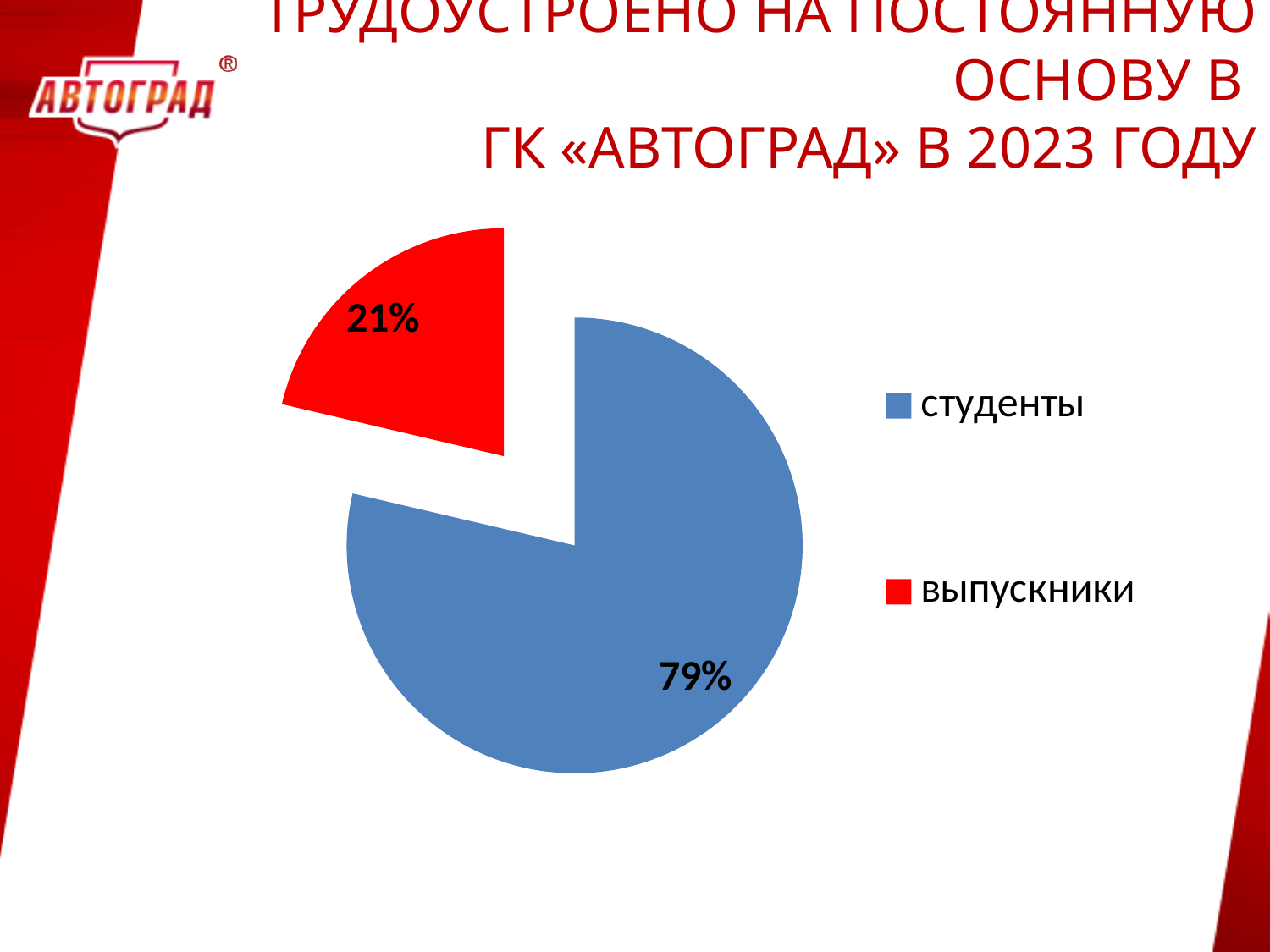
Which category has the largest slice of the pie? студенты How many slices does the pie chart have? 2 What kind of chart is shown on the slide? pie chart What share of the pie is labelled for студенты? 79% How many entries does the legend list? 2 Which category has the smallest slice of the pie? выпускники What is the total of the two slice percentages shown? 100% What colour is the slice for студенты? blue Which slice is larger, студенты or выпускники? студенты What is the difference in percentage points between the студенты and выпускники slices? 58 What share of the pie is labelled for выпускники? 21% What colour is the slice for выпускники? red